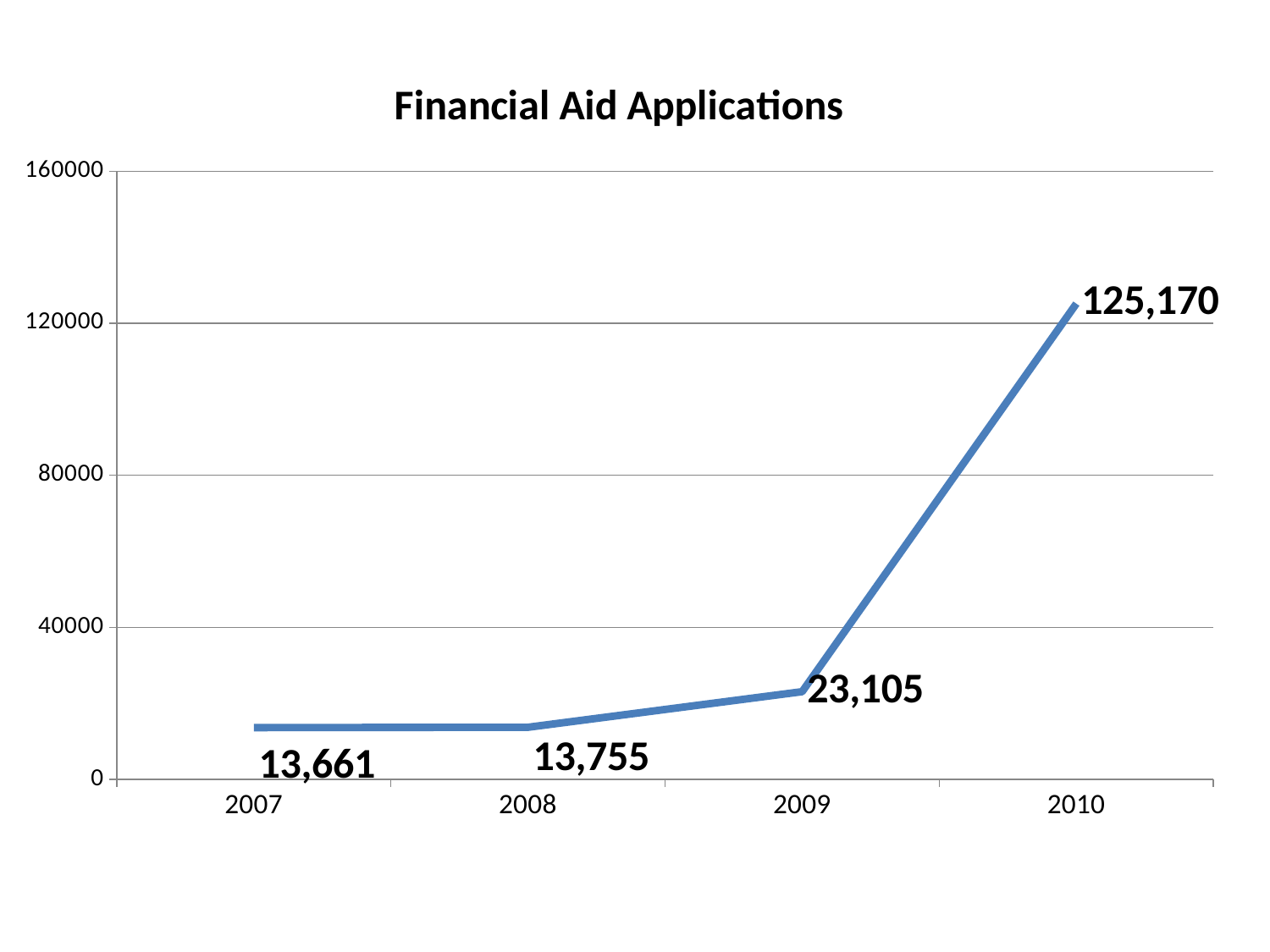
What is the value for 2008? 13,755 What is the value for 2009? 23,105 What is the value for 2007? 13,661 What is the value for 2010? 125,170 Which year has the lowest number of financial aid applications? 2007 What is the difference between the values for 2009 and 2008? 9,350 Which year has the highest number of financial aid applications? 2010 What is the difference between the values for 2010 and 2009? 102,065 Do the values rise or fall from 2007 to 2010? rise Which is larger, the value for 2008 or the value for 2009? 2009 What kind of chart is this? line chart How many years are plotted on the chart? 4